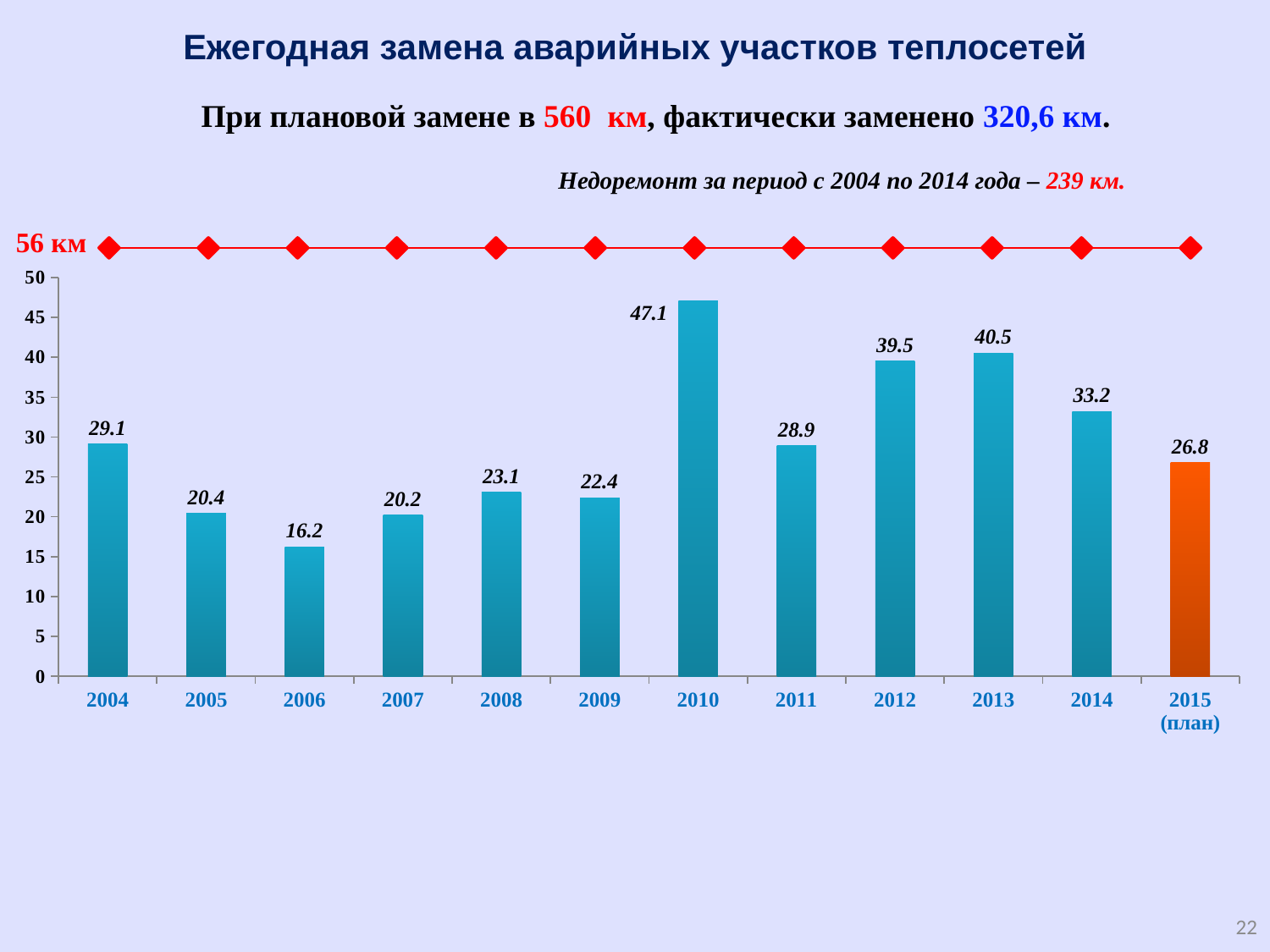
How many bars are shown in the chart? 12 What is the difference between the values for 2013 and 2012? 1.0 What kind of chart is this? bar chart Which year has the lowest bar? 2006 What is the value for 2006? 16.2 What is the value for 2015 (план)? 26.8 What value does the red horizontal line represent? 56 км Which is larger, the value for 2004 or the value for 2011? 2004 Is the value for 2014 greater or less than 30? greater Which year has the highest bar? 2010 What is the value for 2010? 47.1 Do the values rise or fall from 2011 to 2013? rise